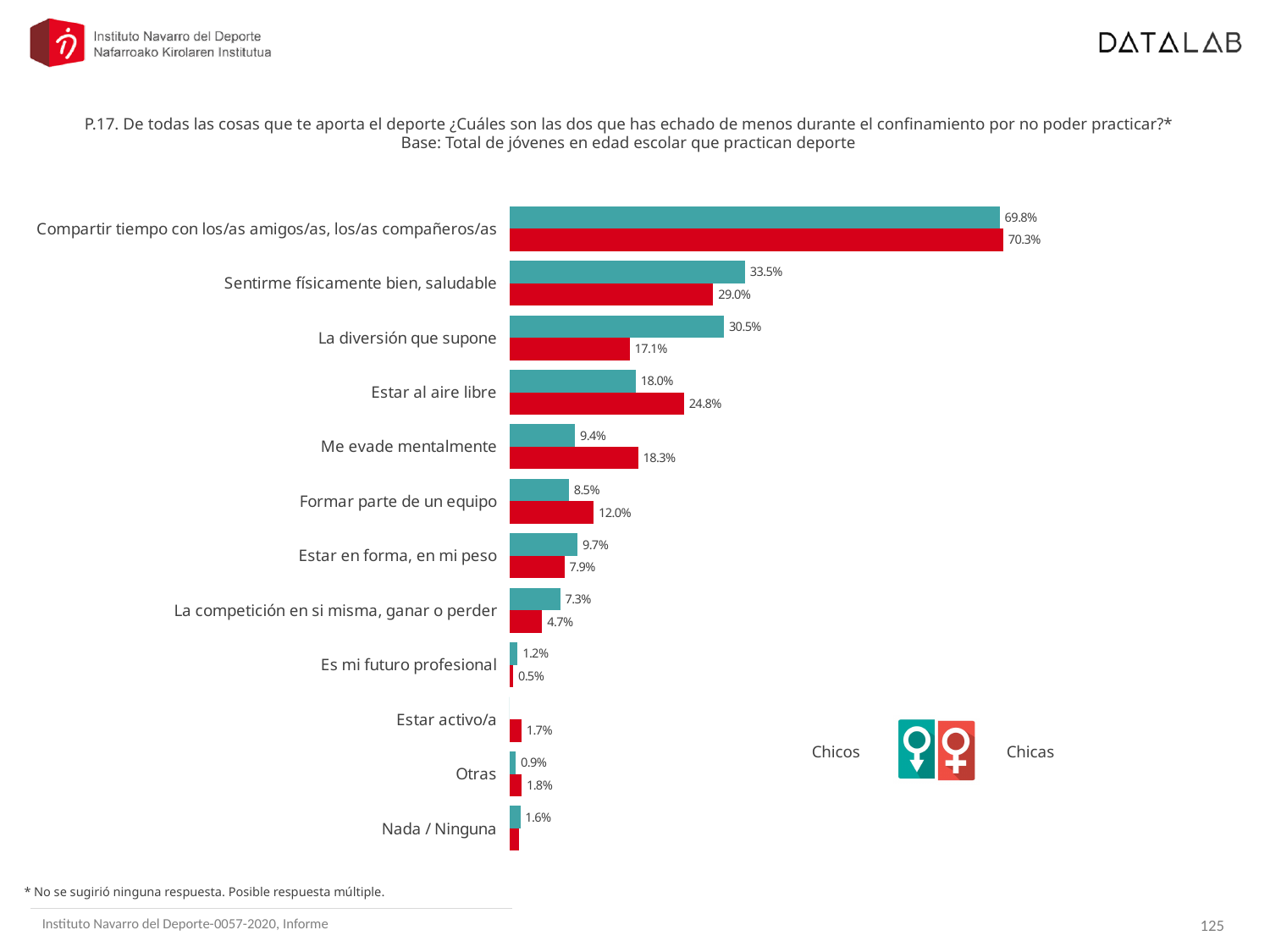
What is the value for Chicas for "Estar al aire libre"? 24.8% What kind of chart is shown on the slide? Bar chart For "Estar en forma, en mi peso", which is larger, the Chicos value or the Chicas value? Chicos How many categories are shown on the chart? 12 What is the difference between the Chicos and Chicas values for "Sentirme físicamente bien, saludable"? 4.5 percentage points What is the value for Chicas for "Me evade mentalmente"? 18.3% What is the value for Chicos for "La diversión que supone"? 30.5% What is the difference between the Chicos and Chicas values for "La diversión que supone"? 13.4 percentage points How many series does the legend list? 2 For "Formar parte de un equipo", which is larger, the Chicos value or the Chicas value? Chicas Which category has the highest value for Chicas? Compartir tiempo con los/as amigos/as, los/as compañeros/as Which category has the lowest labelled value for Chicas? Es mi futuro profesional